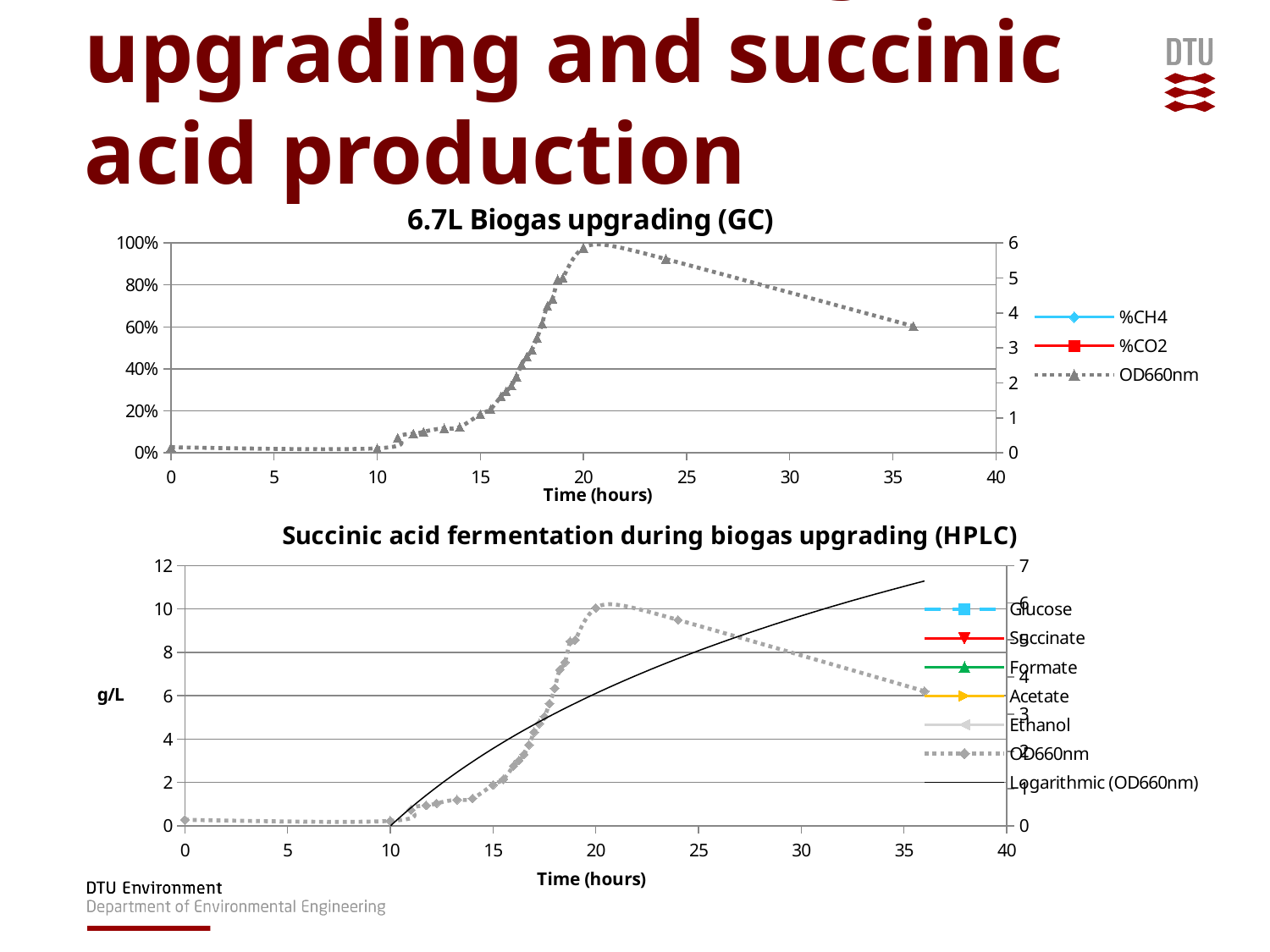
What is the title of the top chart? 6.7L Biogas upgrading (GC) In the top chart, 6.7L Biogas upgrading (GC), is the OD660nm value at 36 hours greater or less than 3 on the right axis? greater How many series does the legend of the top chart, 6.7L Biogas upgrading (GC), list? 3 In the bottom chart, Succinic acid fermentation during biogas upgrading (HPLC), does the Logarithmic (OD660nm) line rise or fall from 10 to 36 hours? rise What is the x-axis label of the bottom chart, Succinic acid fermentation during biogas upgrading (HPLC)? Time (hours) In the top chart, 6.7L Biogas upgrading (GC), does the OD660nm series rise or fall between 20 and 36 hours? fall In the top chart, 6.7L Biogas upgrading (GC), does the OD660nm series rise or fall between 10 and 20 hours? rise What kind of chart is the top chart, 6.7L Biogas upgrading (GC)? line chart How many entries does the legend of the bottom chart, Succinic acid fermentation during biogas upgrading (HPLC), list? 7 In the top chart, 6.7L Biogas upgrading (GC), is the OD660nm value at 10 hours greater or less than 1 on the right axis? less What is the title of the bottom chart? Succinic acid fermentation during biogas upgrading (HPLC)